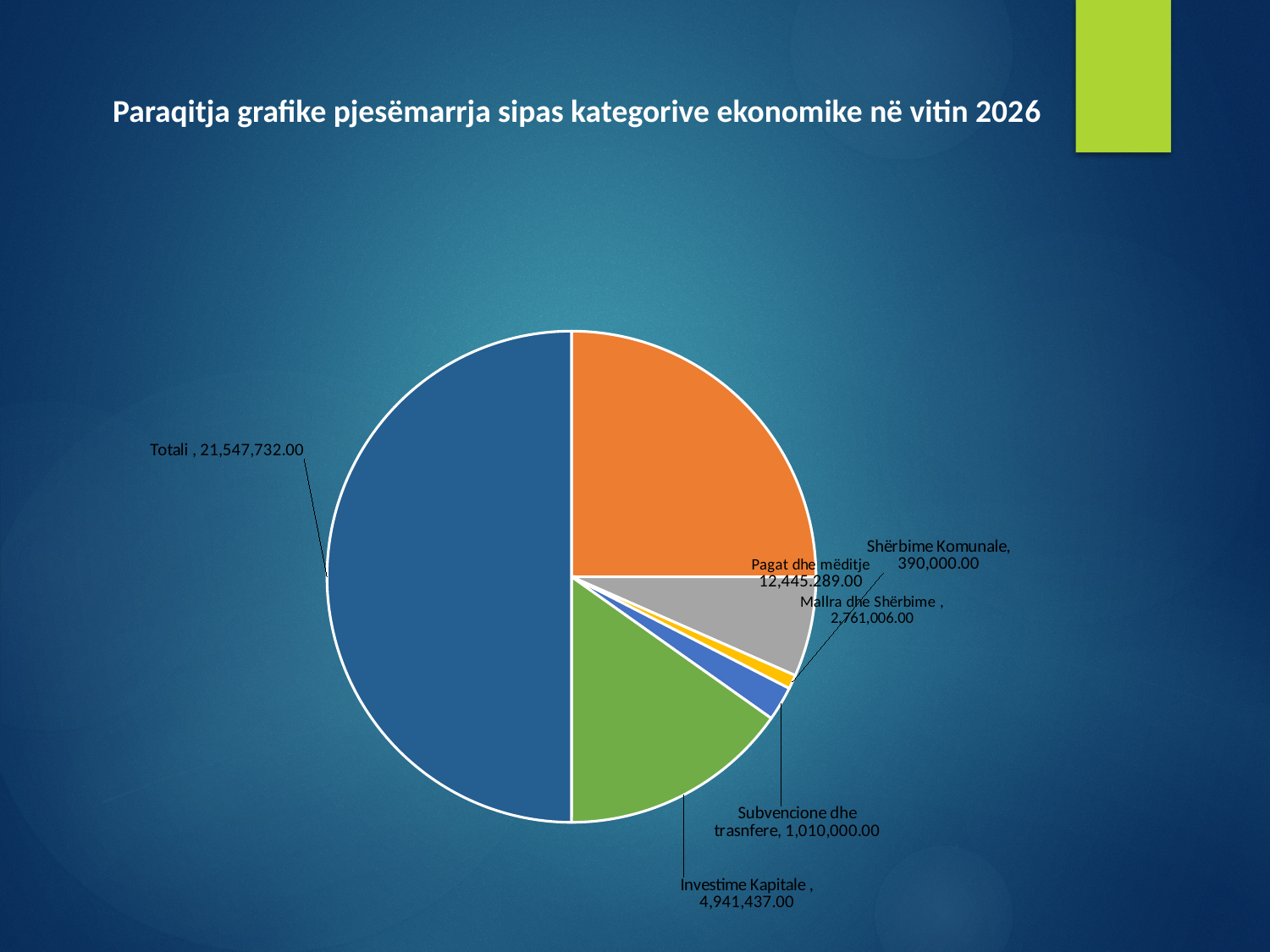
Which slice has the smallest value? Shërbime Komunale What is the value shown for Mallra dhe Shërbime? 2,761,006.00 What is the title of the chart? Paraqitja grafike pjesëmarrja sipas kategorive ekonomike në vitin 2026 What is the value shown for Pagat dhe mëditje? 12,445,289.00 What is the value shown for Investime Kapitale? 4,941,437.00 What is the value shown for Subvencione dhe trasnfere? 1,010,000.00 How many slices does the pie chart have? 6 What type of chart is shown on the slide? Pie chart What is the value shown for Shërbime Komunale? 390,000.00 Which slice has the largest value? Totali Which is larger, the value for Mallra dhe Shërbime or the value for Subvencione dhe trasnfere? Mallra dhe Shërbime What is the difference between the values for Pagat dhe mëditje and Investime Kapitale? 7,503,852.00